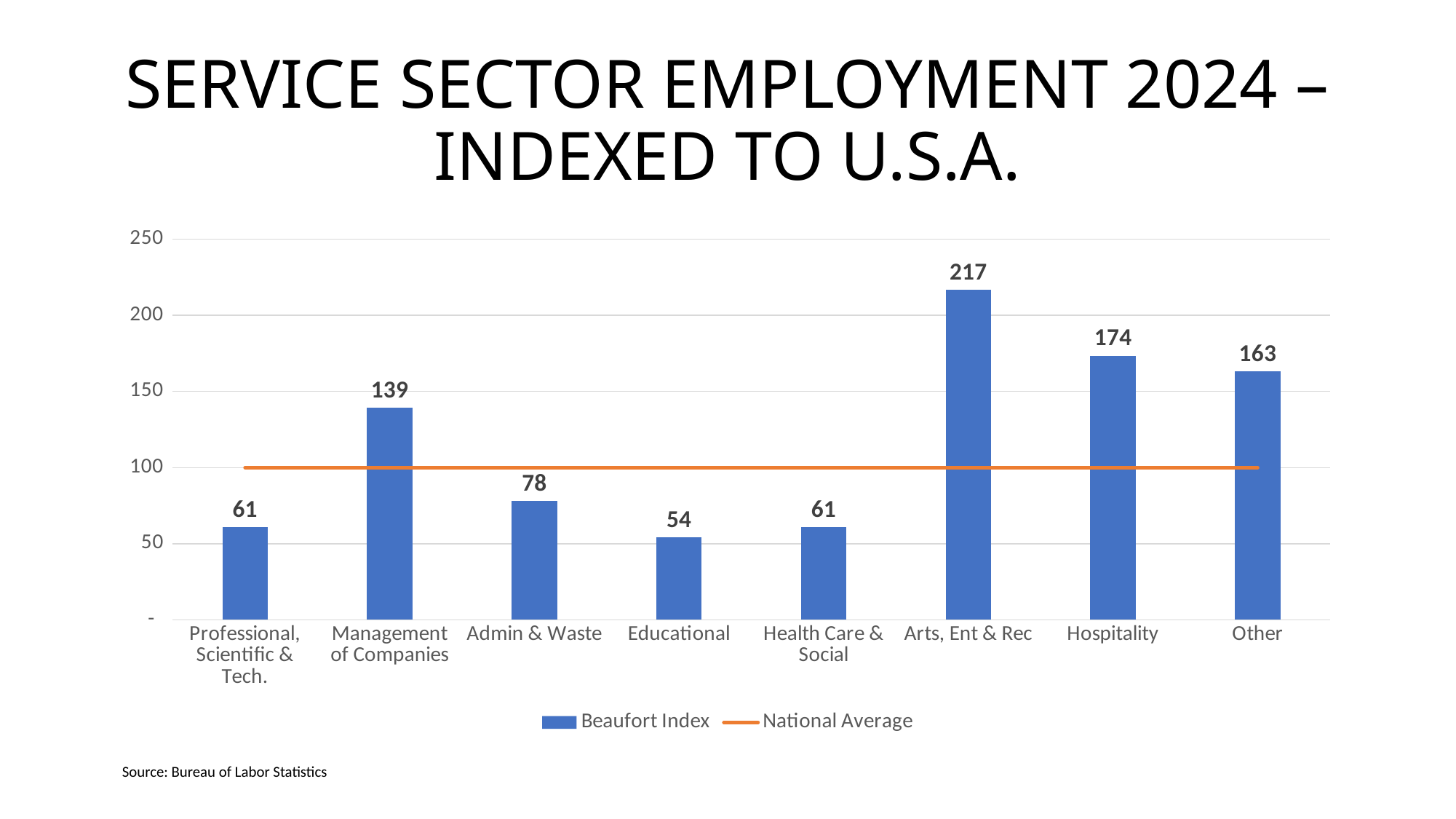
What is the Beaufort Index value for Educational? 54 What is the difference between the Beaufort Index values for Hospitality and Other? 11 How many categories are shown on the x axis? 8 What is the Beaufort Index value for Arts, Ent & Rec? 217 What is the Beaufort Index value for Management of Companies? 139 How many series does the legend list? 2 Is the Beaufort Index value for Hospitality greater or less than 150? greater What kind of chart is shown on the slide? Bar chart with a line Which category has the lowest Beaufort Index value? Educational Which has a larger Beaufort Index value, Admin & Waste or Health Care & Social? Admin & Waste What is the title of the chart on the slide? SERVICE SECTOR EMPLOYMENT 2024 – INDEXED TO U.S.A. Which category has the highest Beaufort Index value? Arts, Ent & Rec